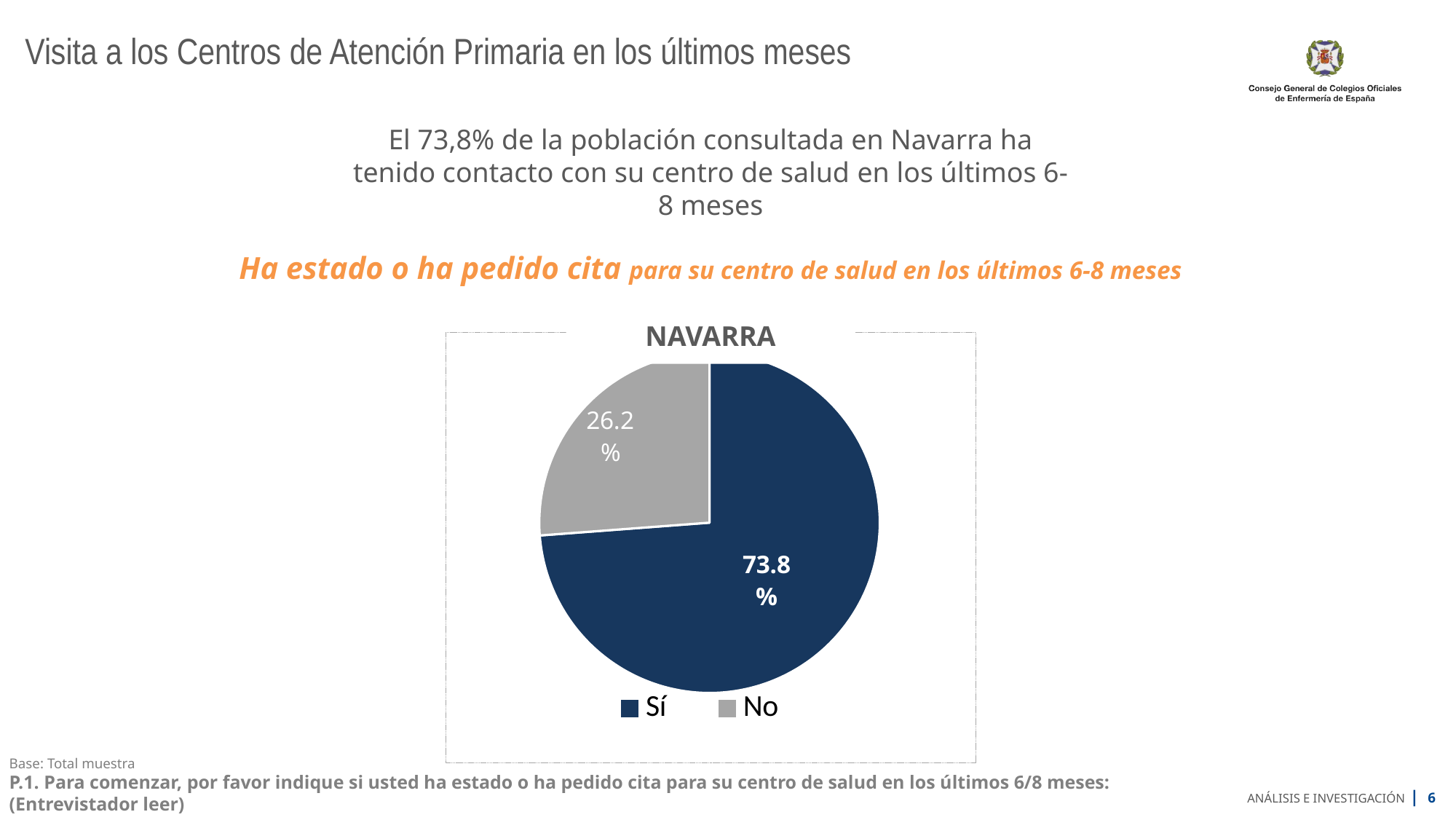
What type of chart is shown on the slide? Pie chart What percentage of the pie corresponds to "No"? 26.2% Which is larger, the "Sí" slice or the "No" slice? Sí How many slices does the pie chart have? 2 What is the difference in percentage points between the "Sí" and "No" slices? 47.6 Which slice of the pie is the smallest? No How many entries does the legend list? 2 What is the title of the chart? NAVARRA Which slice of the pie is the largest? Sí What percentage of the pie corresponds to "Sí"? 73.8% What colour is the "Sí" slice in the pie chart? Dark blue What is the total of the two slices shown in the pie chart? 100%